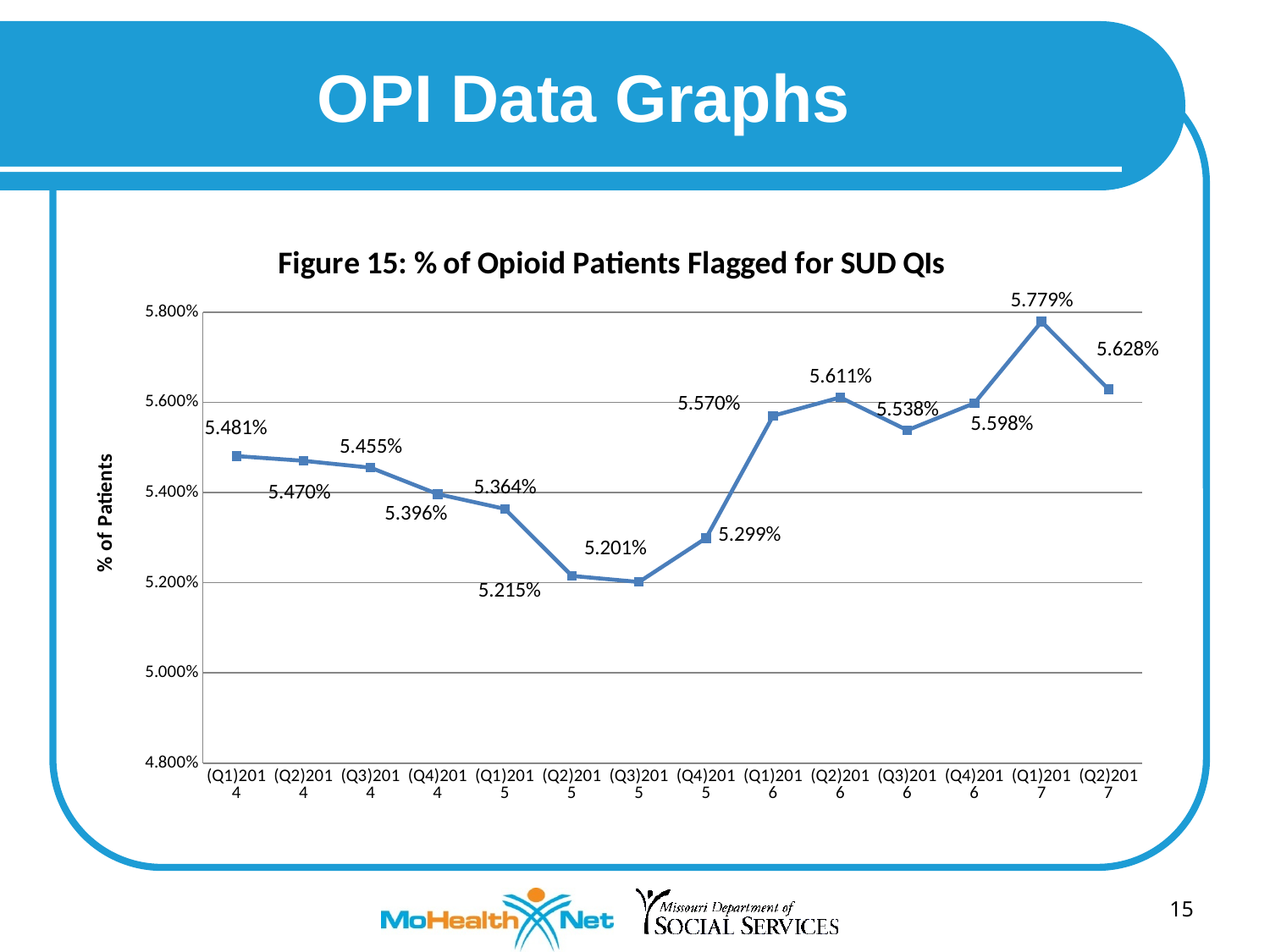
Is the value for (Q4)2015 greater or less than 5.400%? less What is the title of the chart? Figure 15: % of Opioid Patients Flagged for SUD QIs How many quarters are plotted on the chart? 14 What is the value for (Q1)2017? 5.779% What is the value for (Q1)2014? 5.481% What is the value for (Q2)2017? 5.628% Which quarter has the highest % of patients? (Q1)2017 Which is larger, the value for (Q2)2016 or the value for (Q4)2016? (Q2)2016 What is the value for (Q3)2015? 5.201% Which quarter has the lowest % of patients? (Q3)2015 What kind of chart is shown? line chart What is the difference between the values for (Q1)2017 and (Q3)2015? 0.578%